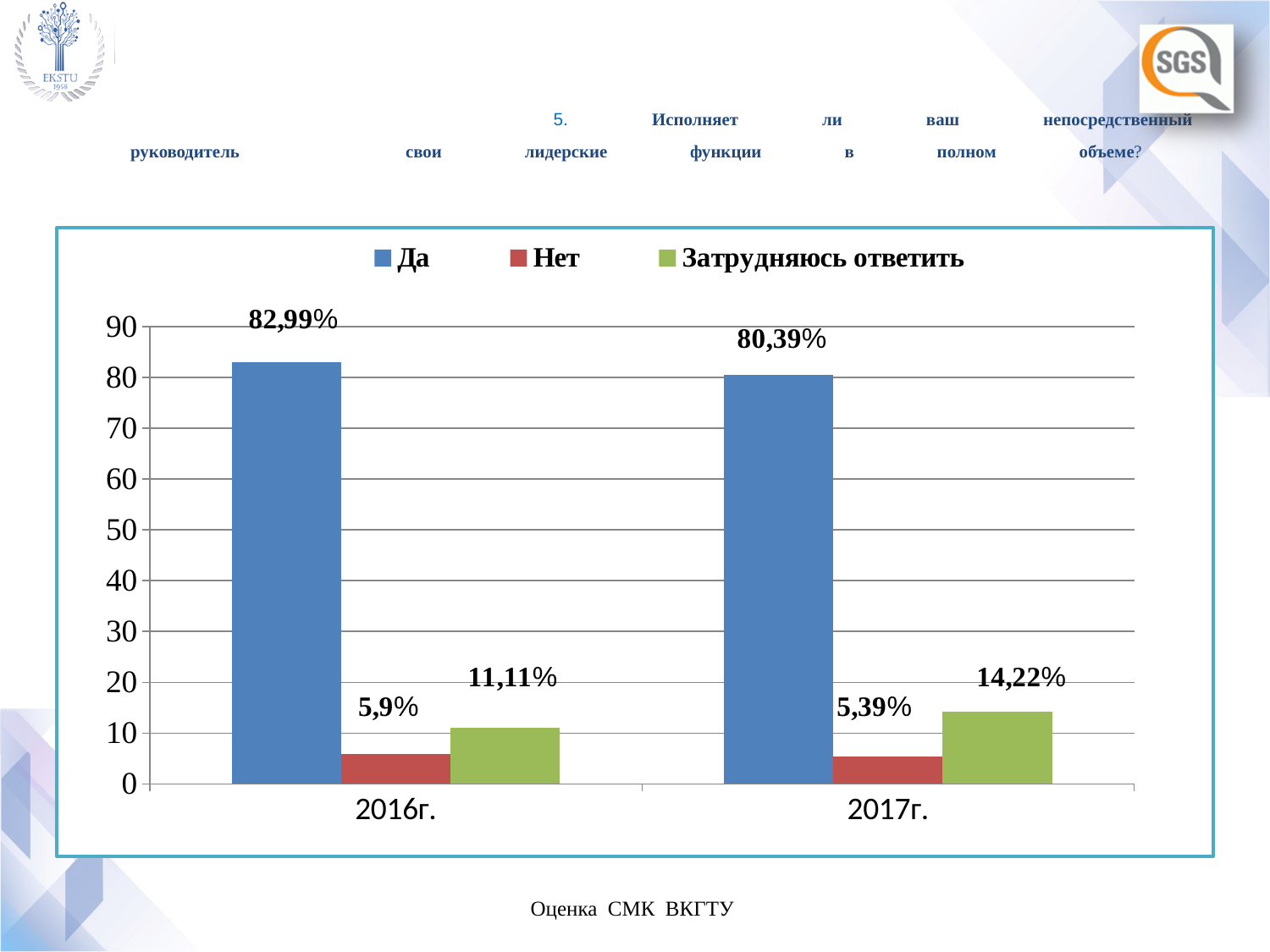
What is the value for "Нет" in 2017г.? 5,39% How many series does the legend list? 3 What kind of chart is shown on the slide? bar chart Which series has the lowest value in 2016г.? Нет Does the value for "Да" rise or fall from 2016г. to 2017г.? fall Which series has the highest value in 2017г.? Да What is the value for "Да" in 2016г.? 82,99% What is the value for "Да" in 2017г.? 80,39% Which is larger: "Затрудняюсь ответить" in 2016г. or in 2017г.? 2017г. Is the value for "Нет" in 2016г. greater or less than 10? less What is the difference between the "Да" values for 2016г. and 2017г.? 2,6% What is the value for "Затрудняюсь ответить" in 2016г.? 11,11%